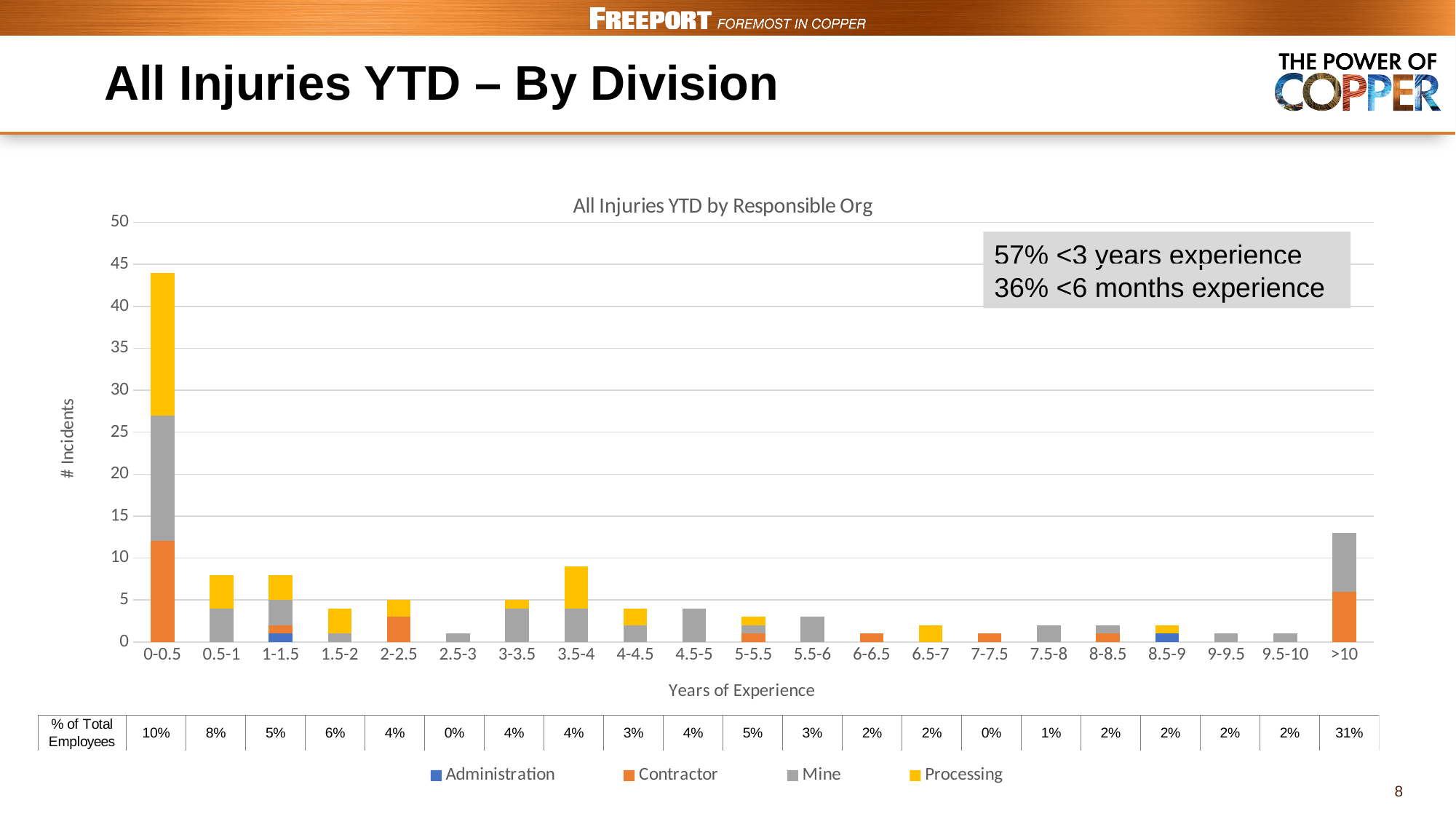
How many series does the legend list? 4 Is the total number of incidents for the 3.5-4 category greater or less than 10? less What is the title of the chart? All Injuries YTD by Responsible Org According to the table below the chart, what is the % of Total Employees for the >10 years category? 31% Which series is shown in yellow in the legend? Processing How many years-of-experience categories are shown on the x axis? 21 Which years-of-experience category has the highest total number of incidents? 0-0.5 Is the total number of incidents for the >10 category greater or less than 10? greater Which has more total incidents, the 0.5-1 category or the 2.5-3 category? 0.5-1 Which has more total incidents, the 0-0.5 category or the >10 category? 0-0.5 What kind of chart is shown on the slide? bar chart Is the total number of incidents for the 0-0.5 category greater or less than 40? greater